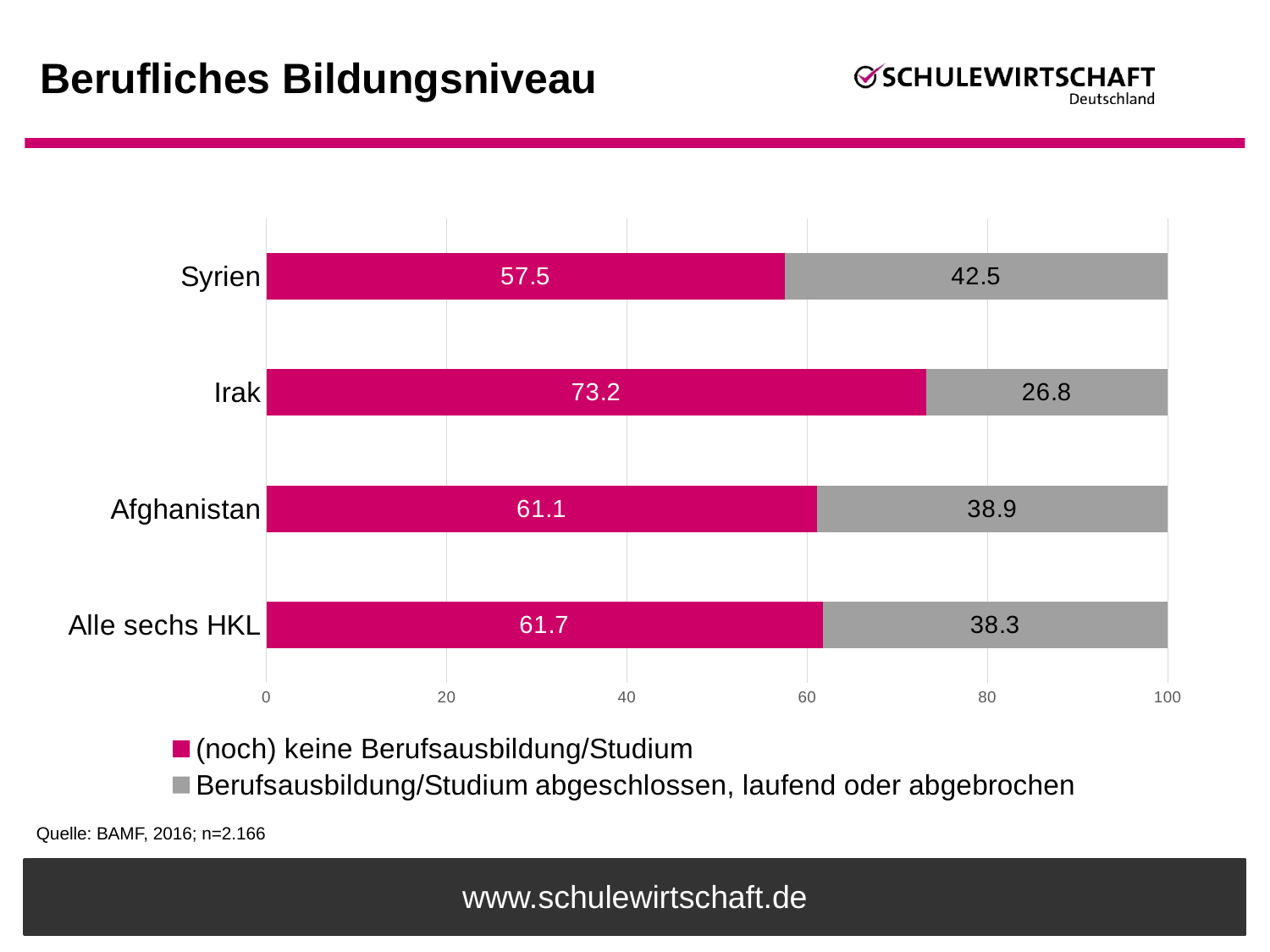
Which is larger: the '(noch) keine Berufsausbildung/Studium' value for Afghanistan or for Syrien? Afghanistan What is the difference between the '(noch) keine Berufsausbildung/Studium' values for Irak and Syrien? 15.7 What is the value for Afghanistan in the '(noch) keine Berufsausbildung/Studium' series? 61.1 Which category has the lowest value in the '(noch) keine Berufsausbildung/Studium' series? Syrien What is the value for Irak in the 'Berufsausbildung/Studium abgeschlossen, laufend oder abgebrochen' series? 26.8 What is the value for Alle sechs HKL in the 'Berufsausbildung/Studium abgeschlossen, laufend oder abgebrochen' series? 38.3 What kind of chart is shown on the slide? Stacked bar chart What is the value for Syrien in the '(noch) keine Berufsausbildung/Studium' series? 57.5 Which category has the highest value in the '(noch) keine Berufsausbildung/Studium' series? Irak How many series does the legend list? 2 Which category has the highest value in the 'Berufsausbildung/Studium abgeschlossen, laufend oder abgebrochen' series? Syrien How many categories are shown on the chart? 4